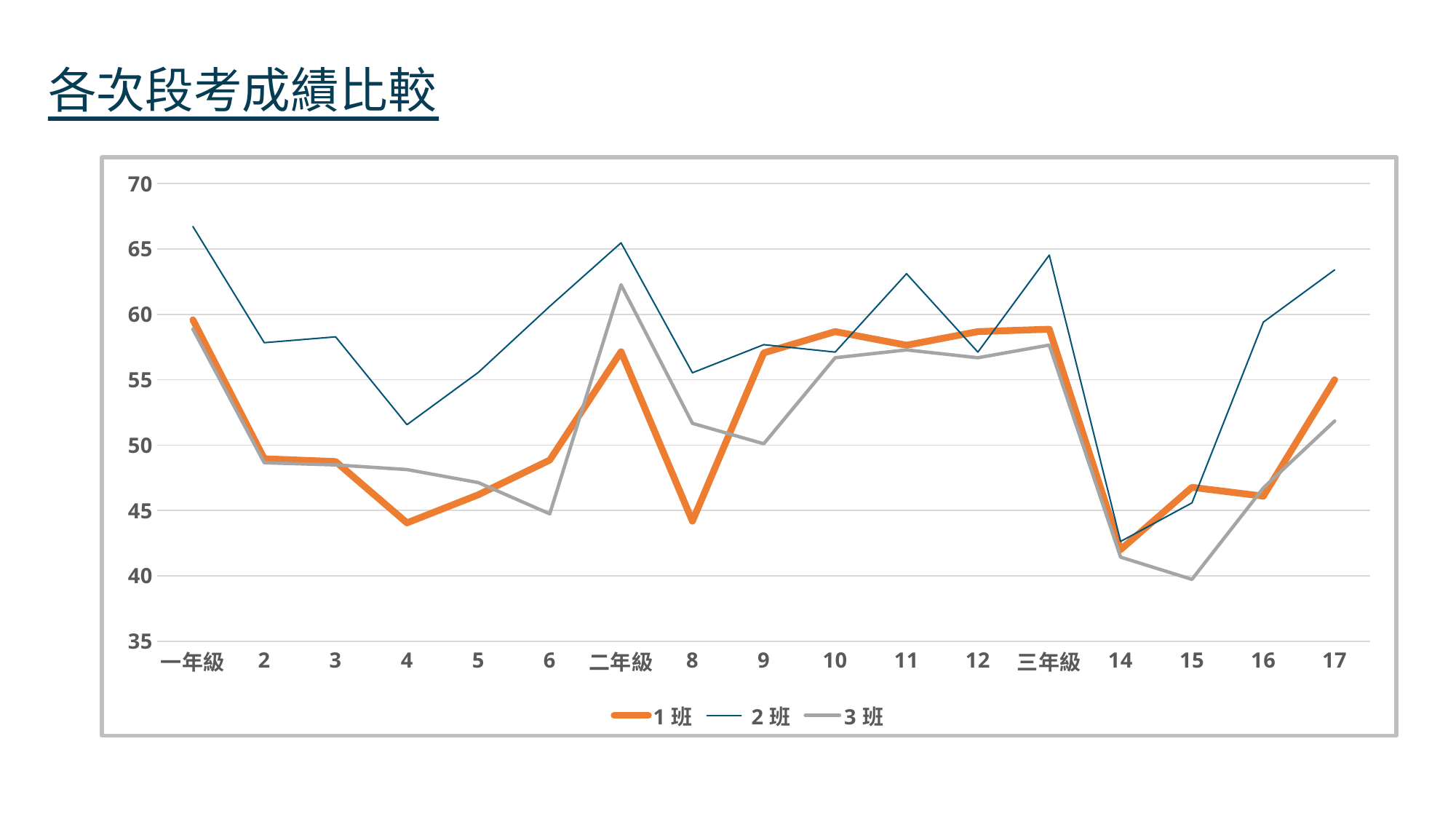
At which category does 3 班 reach its lowest value? 15 What is the title of the slide? 各次段考成績比較 At category 15, which series has the higher value, 1 班 or 3 班? 1 班 Is the value for 3 班 at 二年級 greater or less than 60? greater How many points are plotted along the x axis for each series? 17 Is the value for 1 班 at category 4 greater or less than 45? less Is the value for 2 班 at category 14 greater or less than 45? less At which category does 3 班 reach its highest value? 二年級 What kind of chart is shown on the slide? line chart How many series does the legend list? 3 Does the value for 2 班 rise or fall from category 14 to category 17? rise